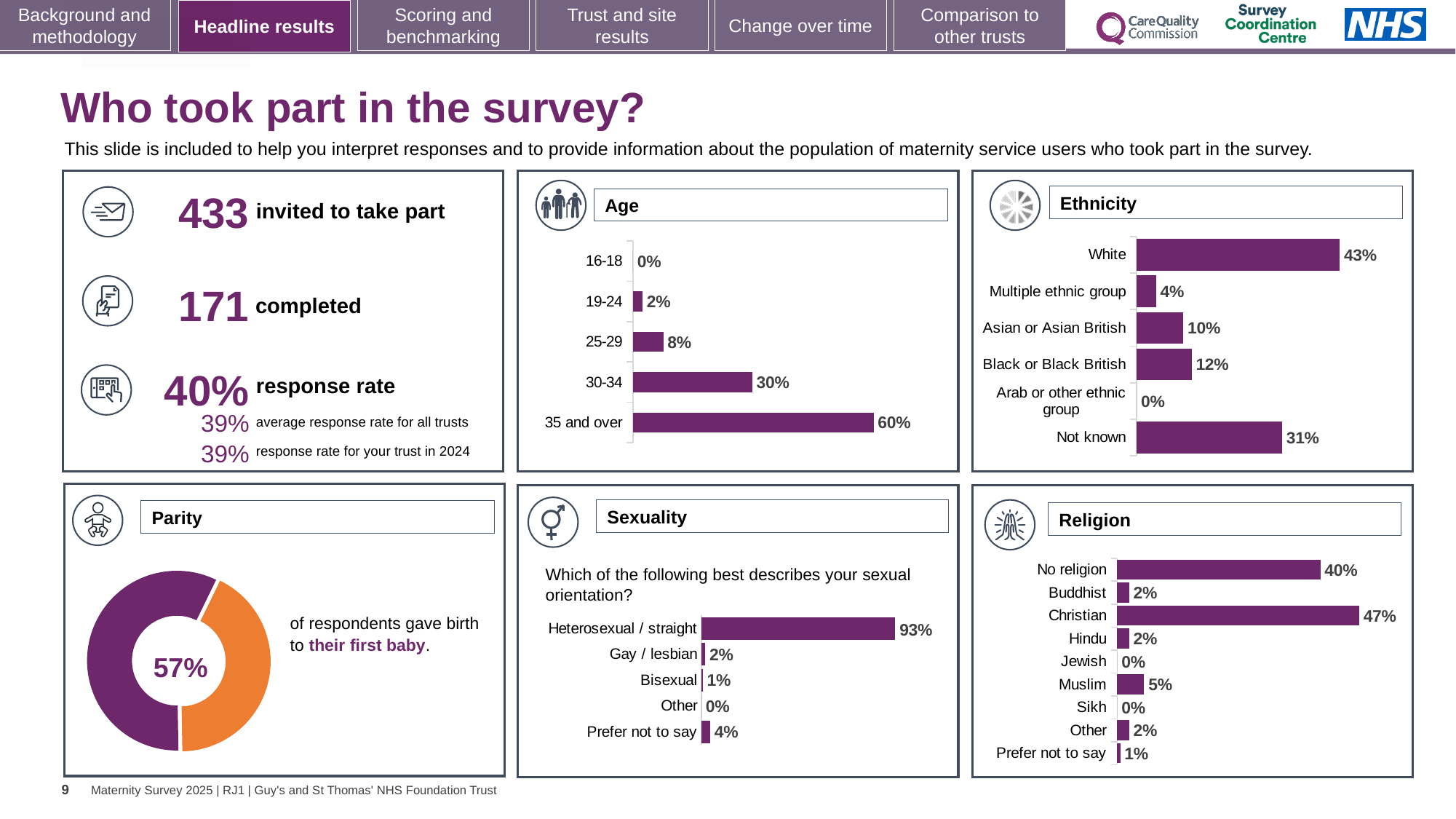
In the Age chart, which age group has the lowest value? 16-18 How many categories are shown in the Ethnicity chart? 6 In the Ethnicity chart, which is larger: Asian or Asian British or Black or Black British? Black or Black British In the Sexuality chart, what is the value for Prefer not to say? 4% In the Ethnicity chart, which category has the highest value? White In the Ethnicity chart, what is the value for Not known? 31% In the Age chart, what percentage of respondents were aged 35 and over? 60% In the Religion chart, what is the difference between Christian and No religion? 7% In the Age chart, what is the difference between the 35 and over group and the 30-34 group? 30% In the Sexuality chart, what percentage of respondents answered Heterosexual / straight? 93% What kind of chart is used in the Parity panel? Doughnut chart In the Religion chart, which category has the highest value? Christian